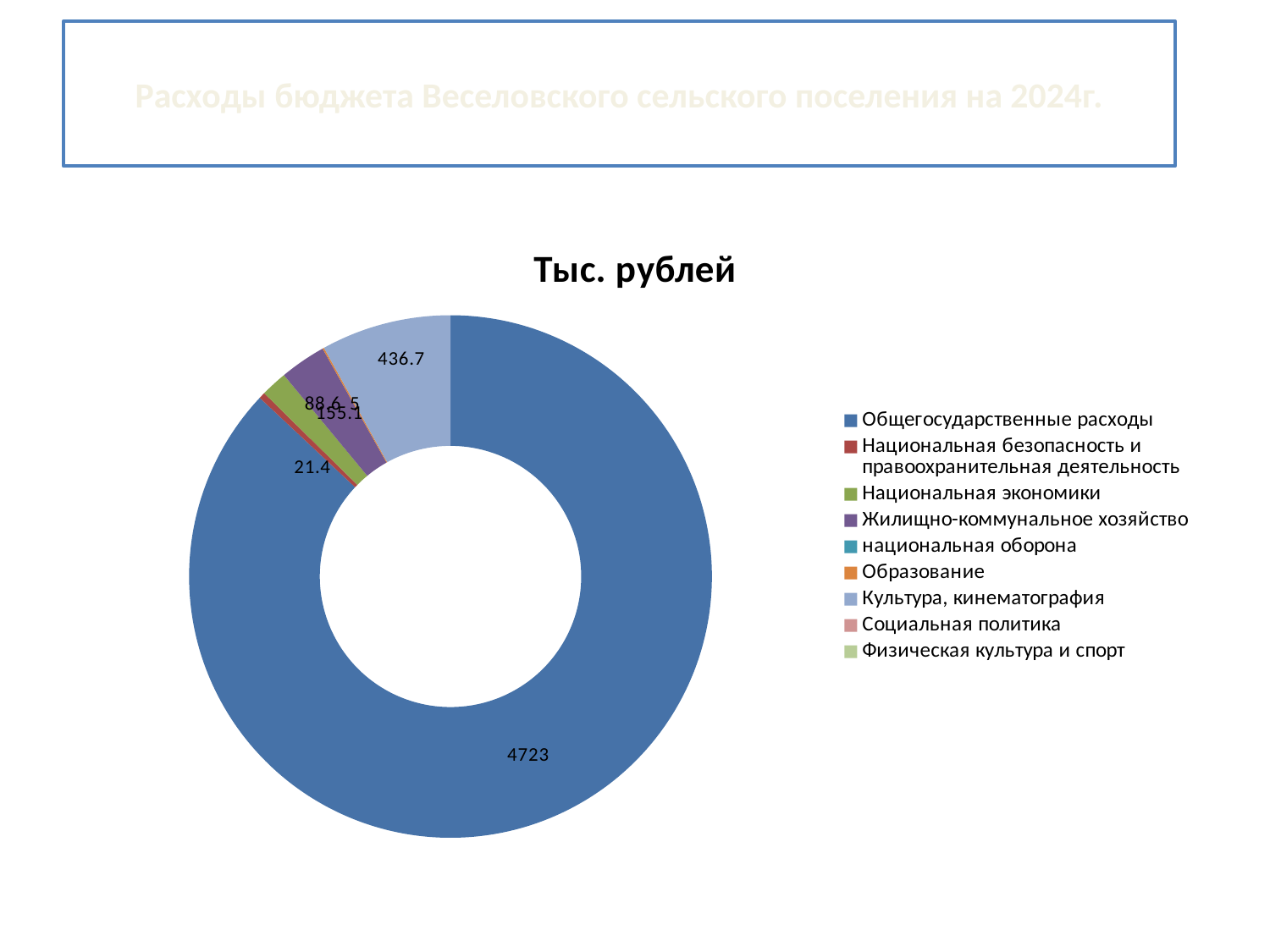
What is the title of the chart? Тыс. рублей What is the value for Национальная безопасность и правоохранительная деятельность? 21.4 How many categories does the chart legend list? 9 What is the value for Культура, кинематография? 436.7 What is the value for Жилищно-коммунальное хозяйство? 155.1 What is the difference between the values for Общегосударственные расходы and Культура, кинематография? 4286.3 What is the value for Общегосударственные расходы? 4723 What colour represents Общегосударственные расходы in the chart? Blue Which category has the largest slice in the chart? Общегосударственные расходы Which is larger: Общегосударственные расходы or Культура, кинематография? Общегосударственные расходы Which is larger: Культура, кинематография or Национальная безопасность и правоохранительная деятельность? Культура, кинематография What kind of chart is shown on the slide? Doughnut (pie) chart